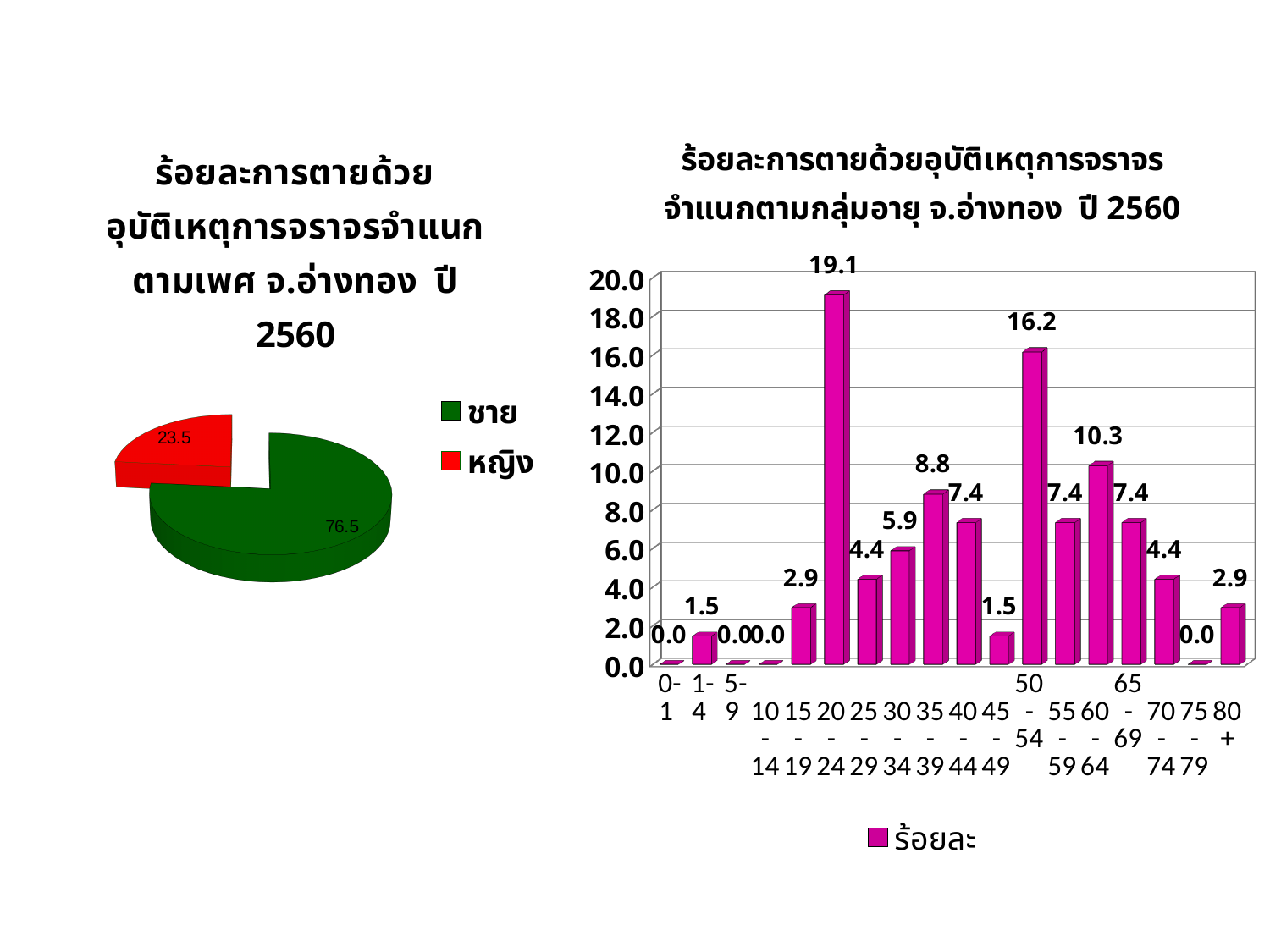
In the bar chart on the right, which age group has the highest value? 20-24 In the bar chart on the right, how many age groups are shown on the x axis? 18 In the bar chart on the right, what is the value for the 50-54 age group? 16.2 In the bar chart on the right, which is larger, the value for 60-64 or the value for 35-39? 60-64 In the bar chart on the right, what is the value for the 20-24 age group? 19.1 What kind of chart is the chart on the left? pie chart In the bar chart on the right, what is the value for the 80+ age group? 2.9 In the pie chart on the left, what is the value for ชาย? 76.5 In the bar chart on the right, what is the difference between the values for 20-24 and 50-54? 2.9 In the pie chart on the left, what is the value for หญิง? 23.5 What kind of chart is the chart on the right? bar chart In the pie chart on the left, which category has the larger share, ชาย or หญิง? ชาย